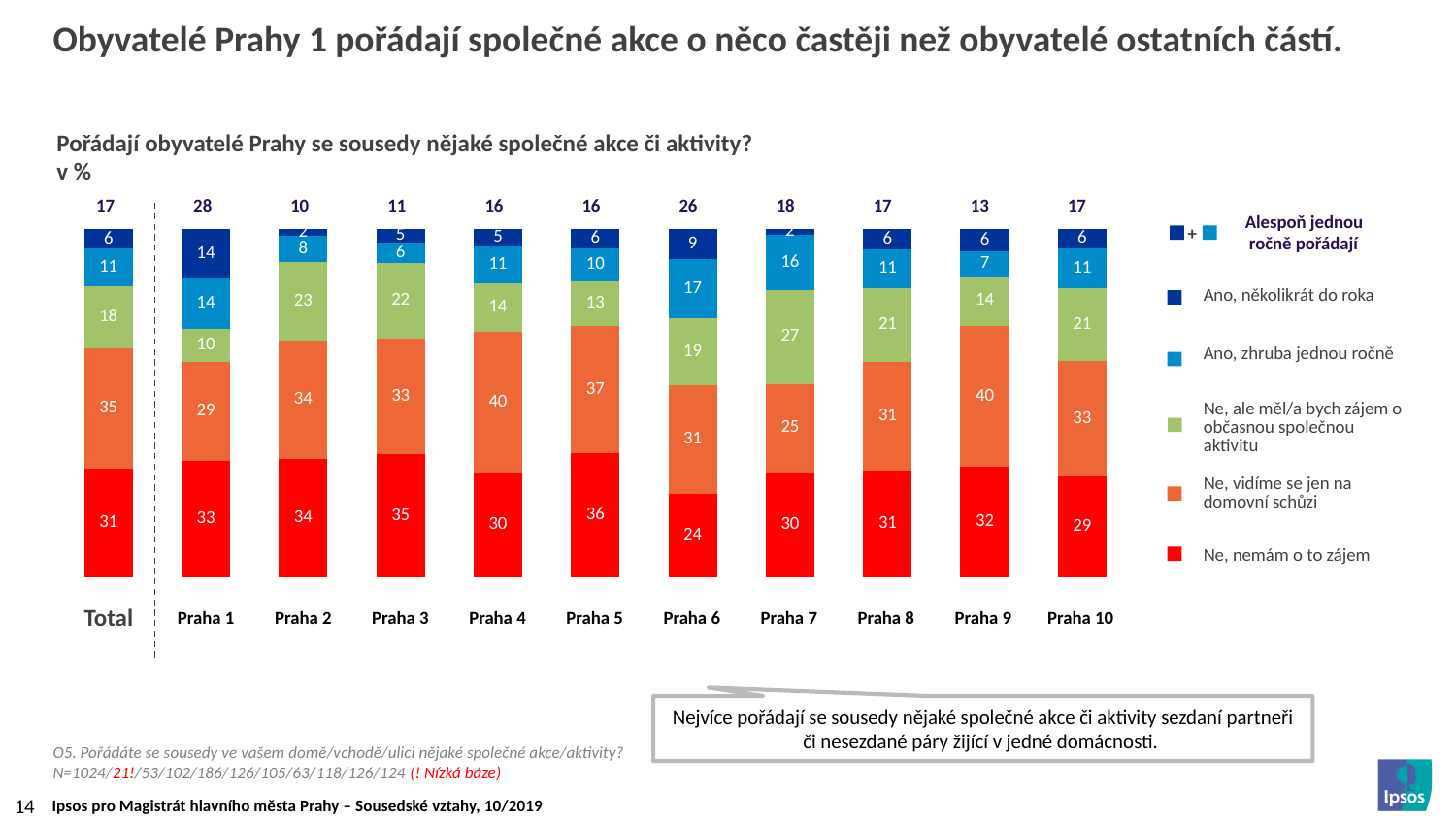
Which category has the lowest value for "Ne, nemám o to zájem"? Praha 6 What is the value for "Ano, zhruba jednou ročně" in the Total bar? 11 What is the value for "Ne, ale měl/a bych zájem o občasnou společnou aktivitu" in Praha 7? 27 How many categories (bars) are shown on the x axis of the chart? 11 How many series does the chart's legend list? 5 Which is larger for "Ne, vidíme se jen na domovní schůzi": Praha 4 or Praha 7? Praha 4 What is the difference between the "Alespoň jednou ročně pořádají" value for Praha 1 and for Total? 11 What is the value for "Ne, nemám o to zájem" in Praha 6? 24 Which category has the highest value for "Ano, několikrát do roka"? Praha 1 What colour represents "Ne, nemám o to zájem" in the chart? Red Which category has the highest value for "Alespoň jednou ročně pořádají" (the number above the bars)? Praha 1 What kind of chart is shown on the slide? Stacked bar chart